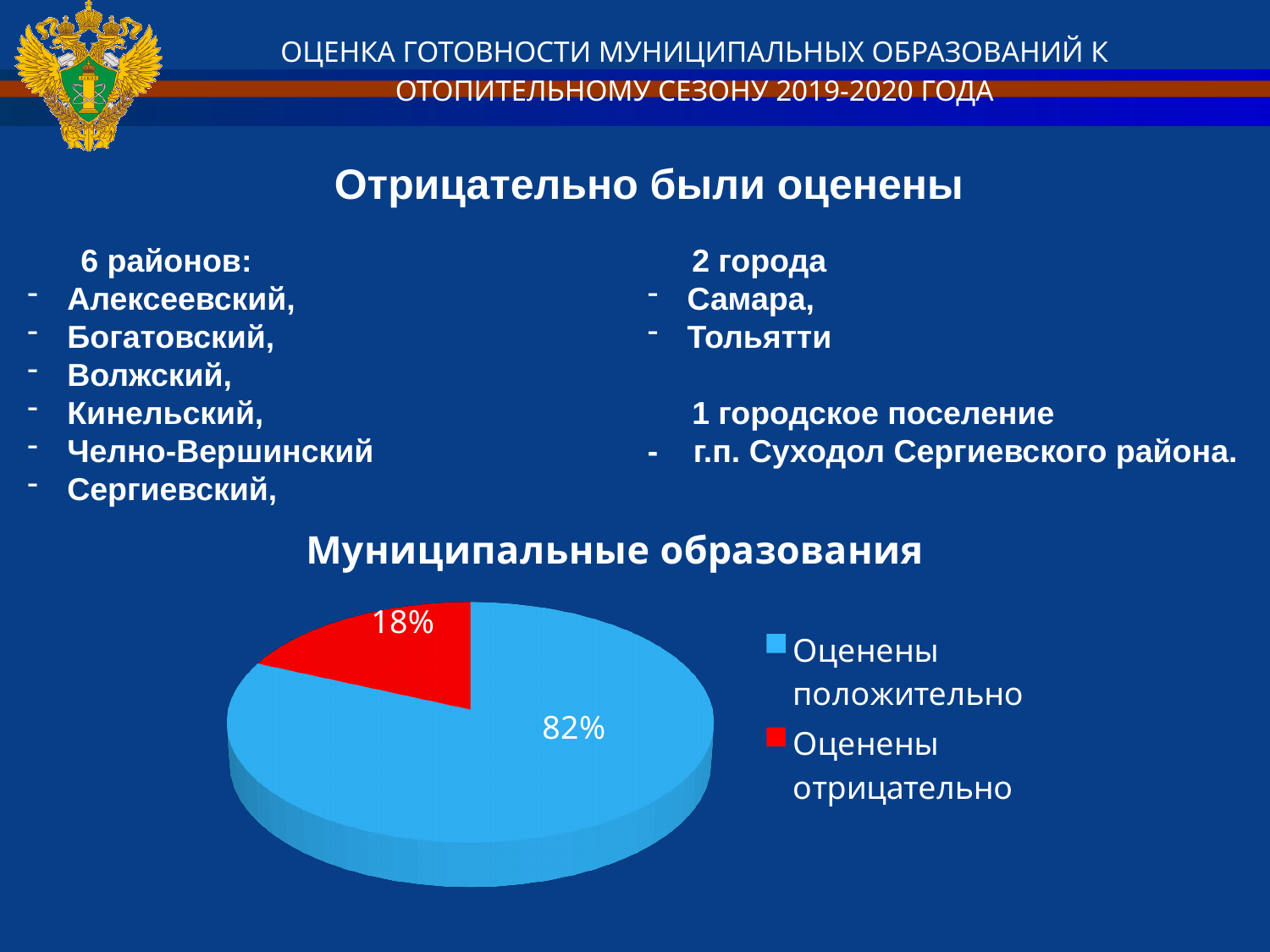
What is the value for "Оценены положительно" in the pie chart? 82% What is the difference between the shares of "Оценены положительно" and "Оценены отрицательно"? 64% What is the value for "Оценены отрицательно" in the pie chart? 18% What colour is the slice for "Оценены отрицательно" in the pie chart? red What is the title of the pie chart? Муниципальные образования Which category has the smallest share of the pie chart? Оценены отрицательно How many slices does the pie chart have? 2 What type of chart is shown under the title "Муниципальные образования"? pie chart Which category has the largest share of the pie chart? Оценены положительно How many entries does the legend of the pie chart list? 2 Which is larger: the share for "Оценены положительно" or for "Оценены отрицательно"? Оценены положительно What share of the pie does the "Оценены отрицательно" slice represent? 18%